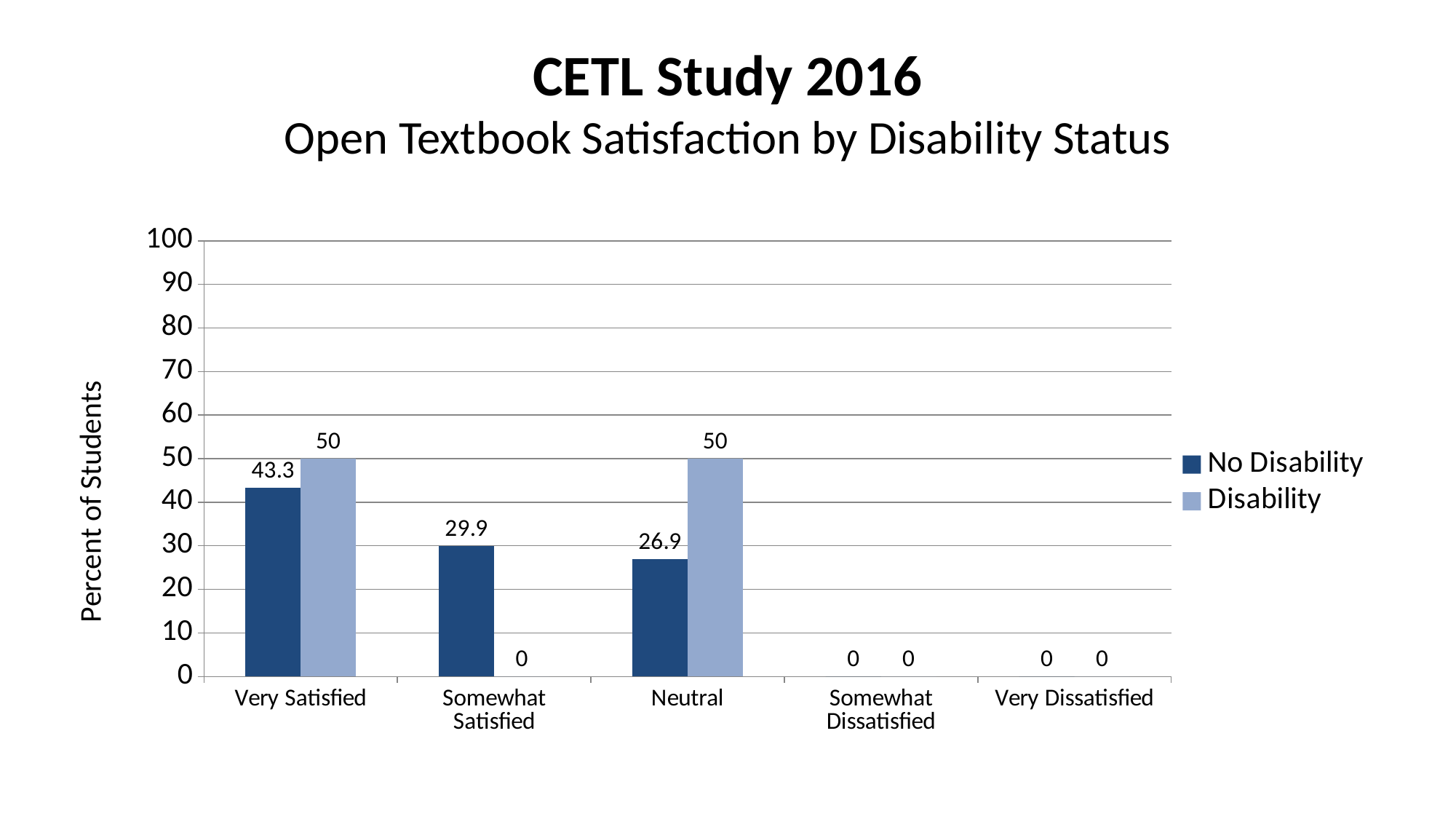
How many categories are shown on the x axis? 5 What is the value for Disability in the Somewhat Satisfied category? 0 Which category has the lowest non-zero value for the No Disability series? Neutral How many series does the legend list? 2 What is the label of the vertical axis? Percent of Students What is the value for No Disability in the Somewhat Satisfied category? 29.9 What kind of chart is shown on the slide? Bar chart In the Neutral category, which series has the larger value, No Disability or Disability? Disability What is the value for Disability in the Neutral category? 50 Which category has the highest value for the No Disability series? Very Satisfied What is the value for No Disability in the Very Satisfied category? 43.3 What is the difference between the Disability and No Disability values in the Very Satisfied category? 6.7